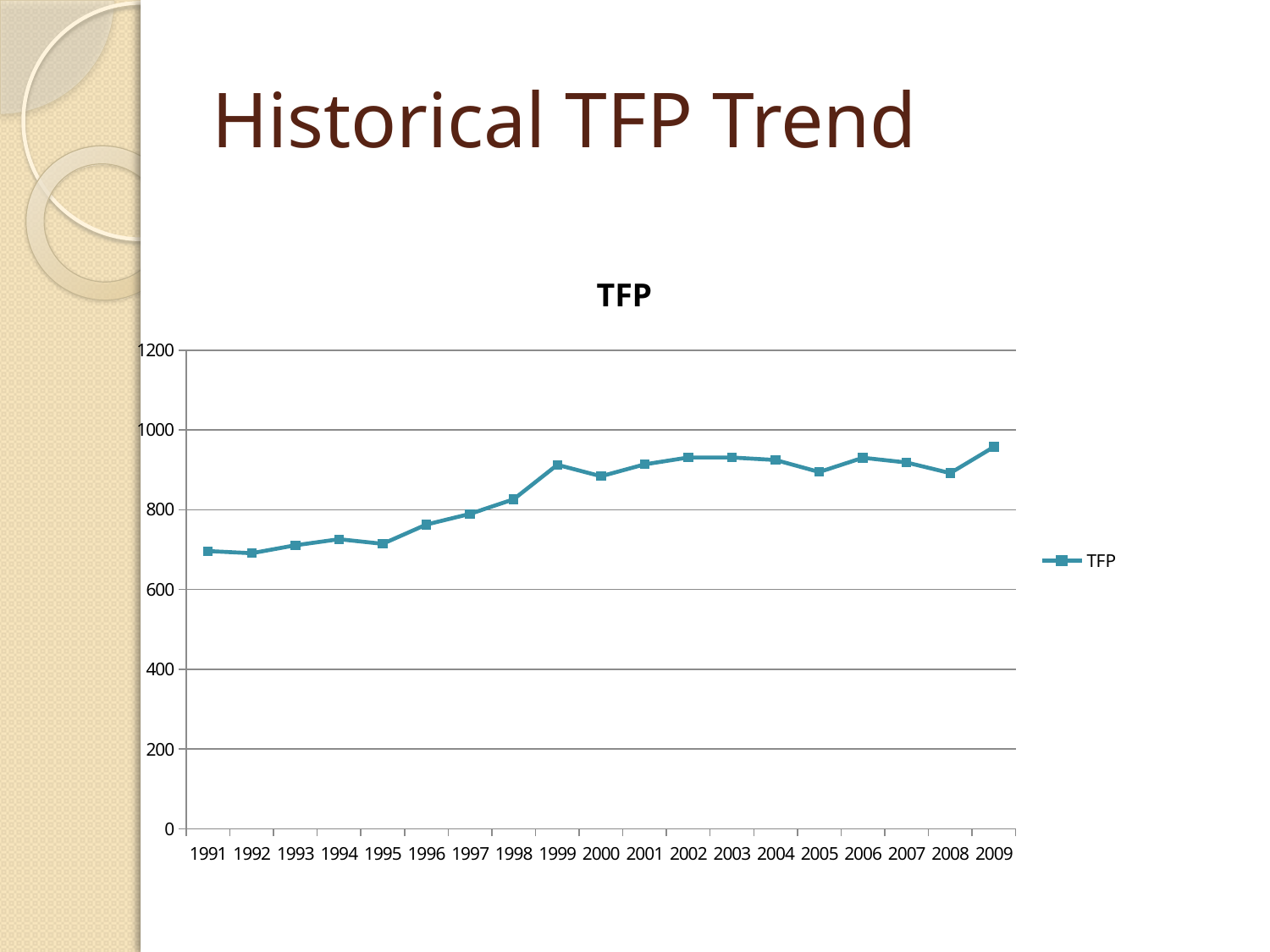
Is the TFP value for 1991 greater or less than 800? less Which year has the larger TFP value, 2008 or 2009? 2009 Overall, does the TFP value rise or fall from 1991 to 2009? rise Is the TFP value for 1999 greater or less than 800? greater Which year has the larger TFP value, 1991 or 1999? 1999 Is the TFP value for 1996 greater or less than 800? less What kind of chart is shown on the slide? line chart How many years are plotted on the x axis? 19 Which year has the highest TFP value? 2009 What is the title of the chart? TFP How many series does the legend list? 1